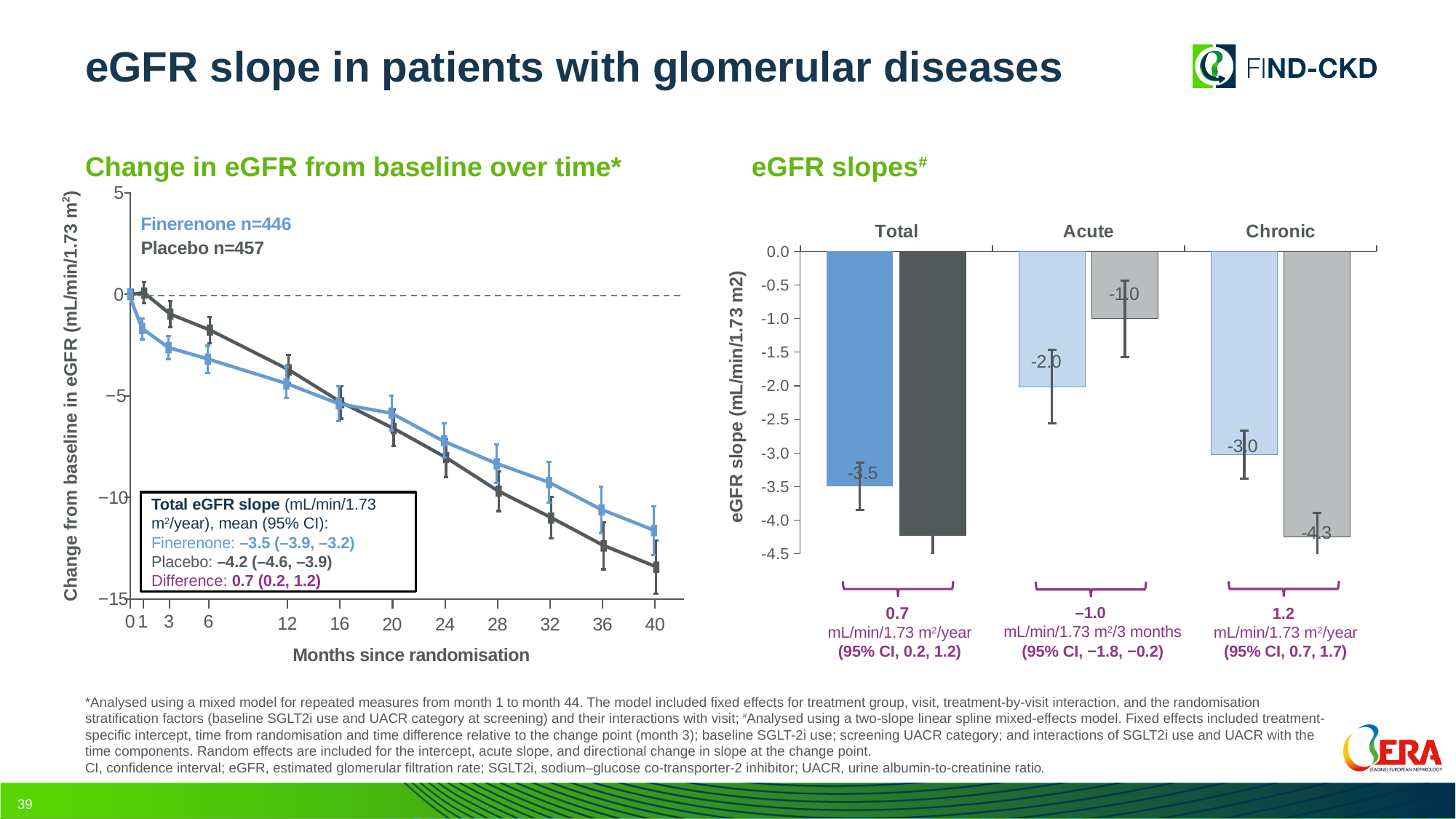
In the 'eGFR slopes#' chart, what is the finerenone value in the Acute group? -2.0 In the 'eGFR slopes#' chart, what is the placebo value in the Chronic group? -4.3 In the 'eGFR slopes#' chart, in the Acute group, which bar is higher (less negative): finerenone or placebo? placebo In the 'Change in eGFR from baseline over time*' chart, is the placebo value at month 40 greater or less than −10? less How many groups (categories) are shown on the x axis of the 'eGFR slopes#' chart? 3 What kind of chart is the left chart, 'Change in eGFR from baseline over time*'? line chart In the 'Change in eGFR from baseline over time*' chart, do the values rise or fall as months since randomisation increase? fall In the 'eGFR slopes#' chart, what is the finerenone value in the Total group? -3.5 In the 'Change in eGFR from baseline over time*' chart, how many patients are in the finerenone group according to the legend? n=446 In the 'eGFR slopes#' chart, which group has the highest (least negative) finerenone bar? Acute What kind of chart is the right chart, 'eGFR slopes#'? bar chart In the 'eGFR slopes#' chart, what is the placebo value in the Acute group? -1.0